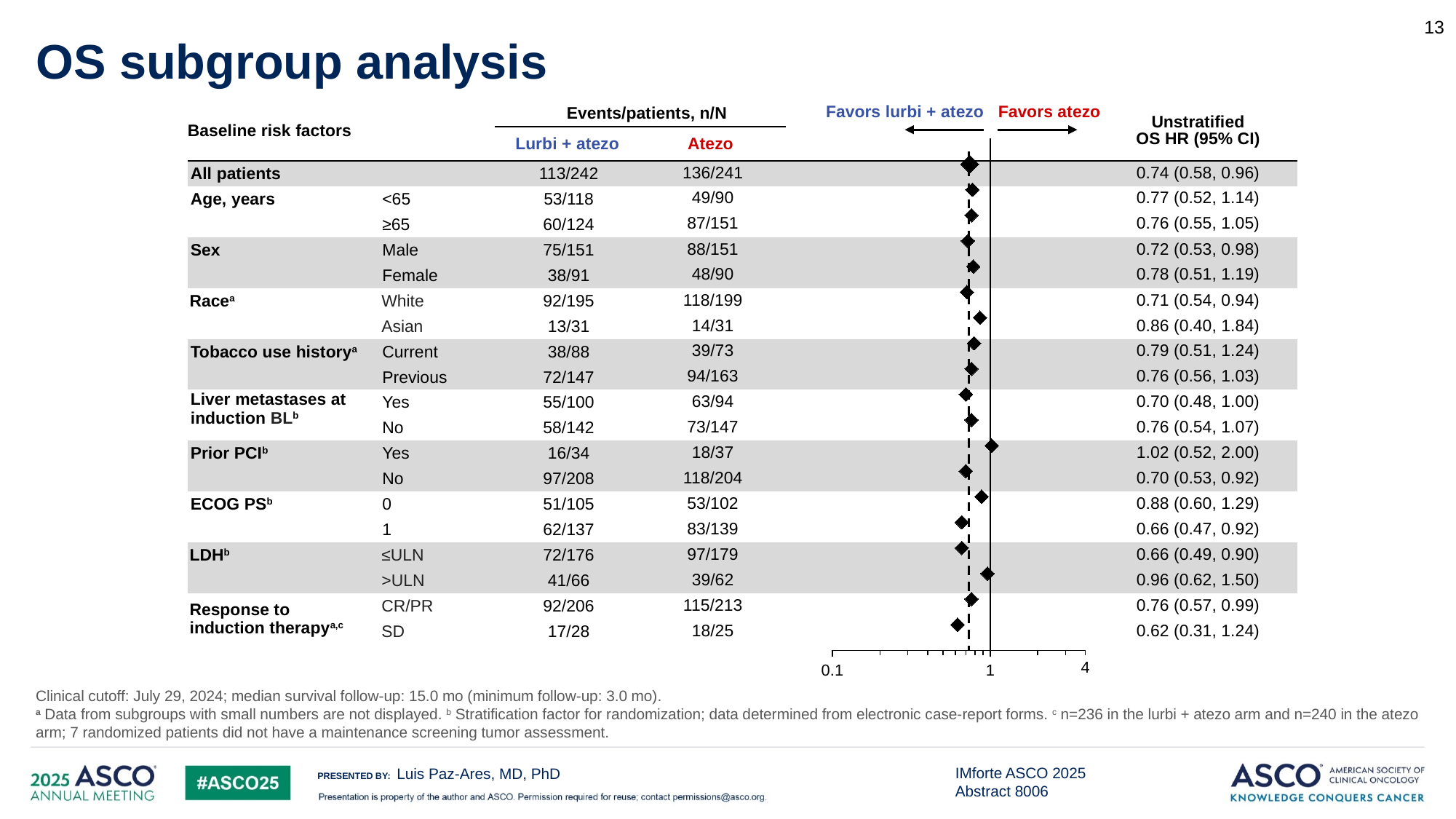
What is the unstratified OS hazard ratio (95% CI) for all patients? 0.74 (0.58, 0.96) How many subgroup rows (including All patients) are plotted in the forest plot? 19 Which subgroup has the highest OS hazard ratio point estimate? Prior PCI, Yes (1.02) What kind of chart is shown on the slide? Forest plot What does the left side of the forest plot (hazard ratio below 1) favor? Lurbi + atezo Is the OS hazard ratio for the Prior PCI = Yes subgroup greater or less than 1? greater What is the events/patients count in the Lurbi + atezo arm for patients aged ≥65? 60/124 What is the difference between the OS hazard ratio for ECOG PS 0 and ECOG PS 1? 0.22 Which subgroup has the lowest OS hazard ratio point estimate? Response to induction therapy, SD (0.62) What is the events/patients count in the Atezo arm for the Asian subgroup? 14/31 Which has the larger OS hazard ratio: LDH ≤ULN or LDH >ULN? LDH >ULN What is the OS hazard ratio for the Prior PCI = Yes subgroup? 1.02 (0.52, 2.00)